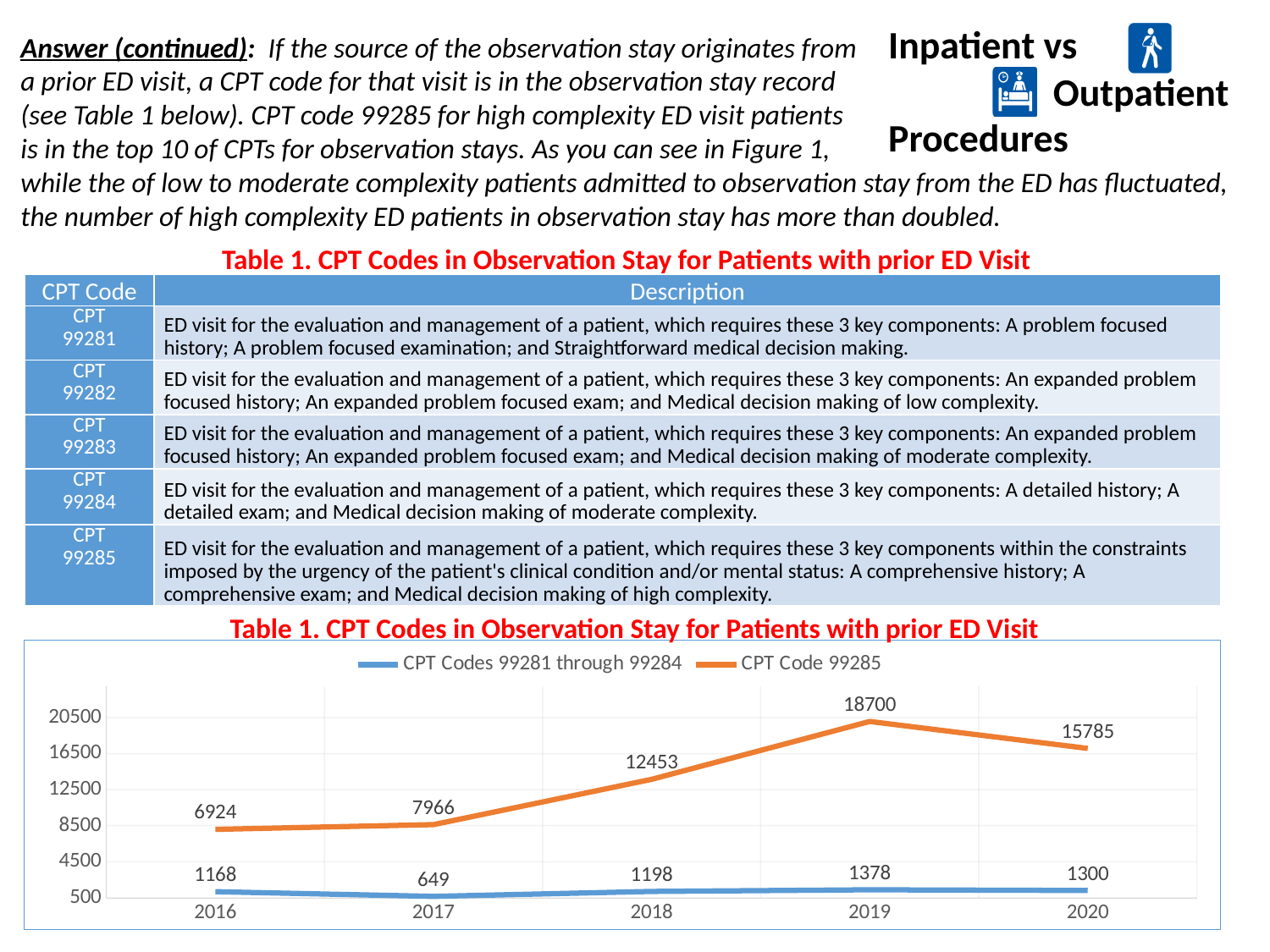
What is the value for CPT Codes 99281 through 99284 in 2017? 649 What colour is the line for CPT Code 99285? orange Does the CPT Code 99285 series rise or fall from 2016 to 2019? rise What is the value for CPT Code 99285 in 2019? 18700 What is the value for CPT Code 99285 in 2016? 6924 How many years are plotted on the x axis of the chart? 5 What is the difference between the CPT Code 99285 values in 2019 and 2020? 2915 In which year is the value for CPT Codes 99281 through 99284 lowest? 2017 How many series does the chart legend list? 2 What type of chart is shown on the slide? line chart In which year is the value for CPT Code 99285 highest? 2019 Which is larger: the CPT Codes 99281 through 99284 value in 2019 or in 2020? 2019